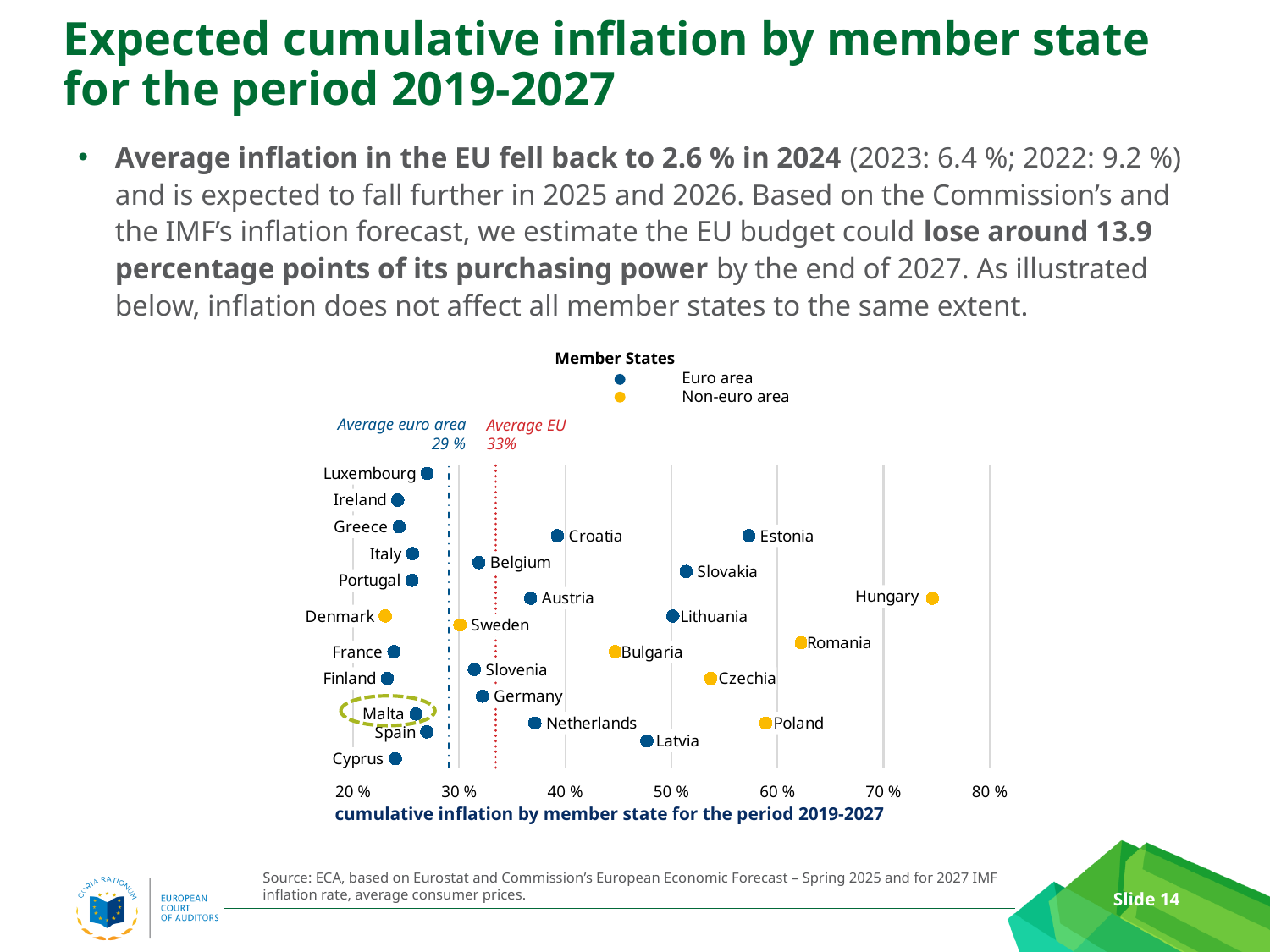
Is the value for Austria greater or less than 40 %? less Which member state has the highest expected cumulative inflation for 2019-2027? Hungary What is the average EU cumulative inflation shown on the chart? 33% What kind of chart is shown on the slide? Scatter (dot) chart Is the value for Hungary greater or less than 70 %? greater How many member states are plotted on the chart? 27 How many series does the legend list? 2 Is the value for Latvia greater or less than 50 %? less Which has the higher cumulative inflation, Romania or Hungary? Hungary How many non-euro area member states are plotted on the chart? 7 What is the average euro area cumulative inflation shown on the chart? 29 % Which member state is highlighted with a dashed circle on the chart? Malta